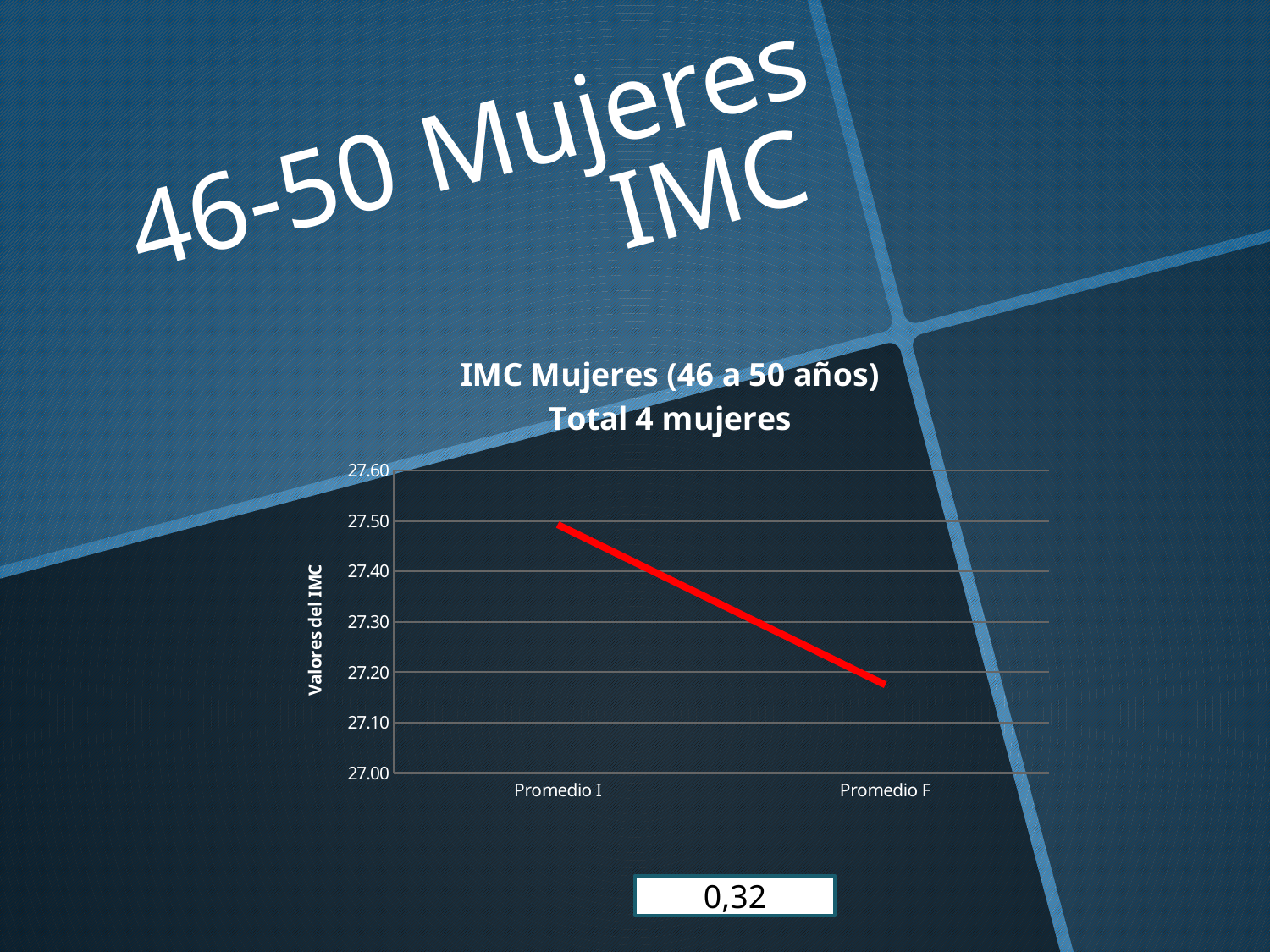
Which category has the highest value? Promedio I Is the value for Promedio I greater or less than 27.60? less What is the label of the vertical axis? Valores del IMC Is the value for Promedio I greater or less than 27.40? greater Is the value for Promedio F greater or less than 27.10? greater Which category has the higher value, Promedio I or Promedio F? Promedio I Which category has the lowest value? Promedio F How many points are plotted on the line? 2 What is the title of the chart? IMC Mujeres (46 a 50 años) Total 4 mujeres Does the line rise or fall from Promedio I to Promedio F? fall What kind of chart is shown on the slide? line chart